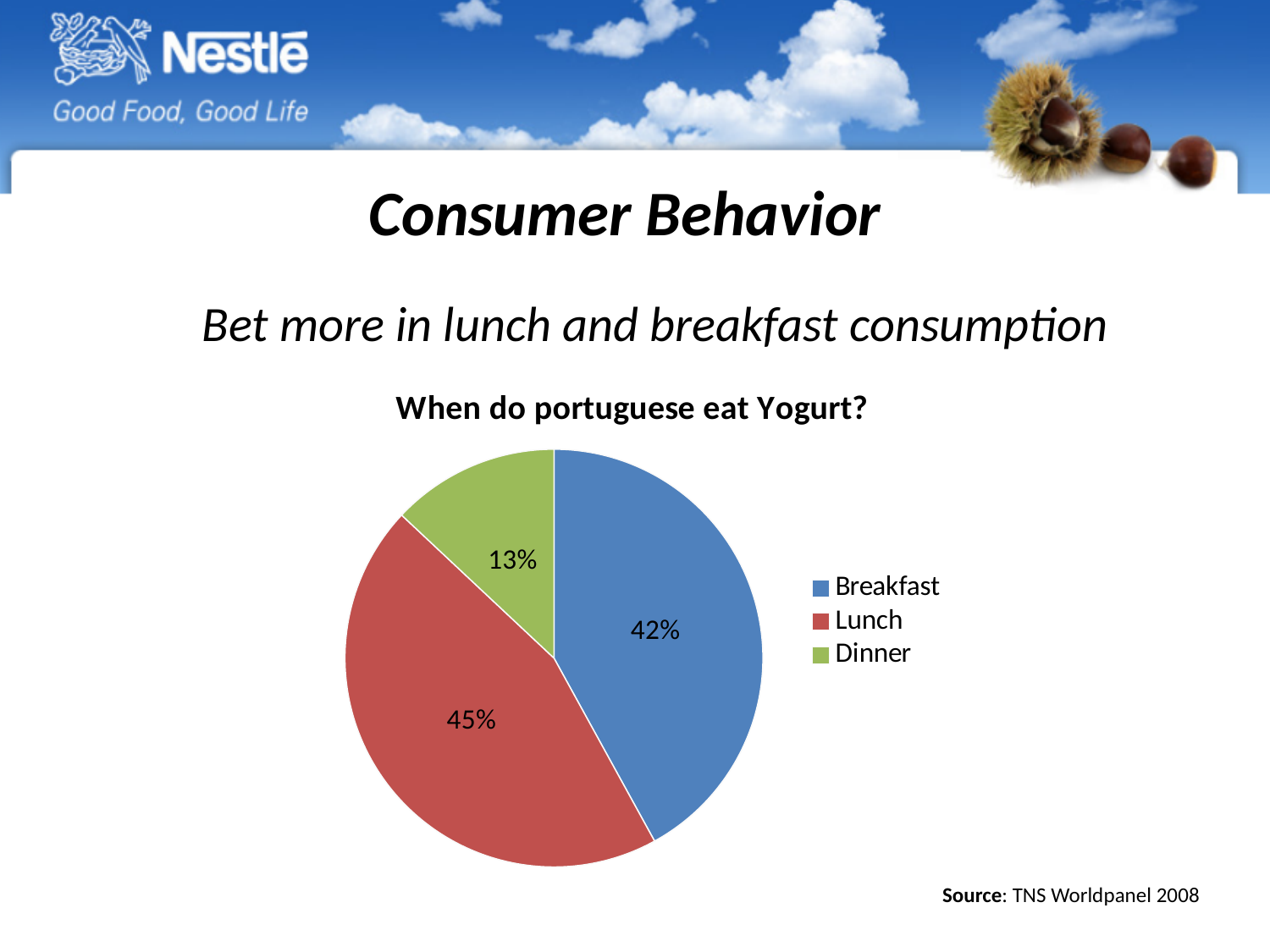
Which category has the smallest slice of the pie? Dinner Which is larger, the Breakfast share or the Dinner share? Breakfast How many categories does the pie chart show? 3 What type of chart is shown on the slide? pie chart What is the title of the chart? When do portuguese eat Yogurt? What is the difference between the Lunch and Breakfast shares? 3% What share of the pie does Breakfast represent? 42% What is the difference between the Lunch and Dinner shares? 32% Which colour represents Dinner in the pie chart? green Which category has the largest slice of the pie? Lunch What share of the pie does Lunch represent? 45% What share of the pie does Dinner represent? 13%